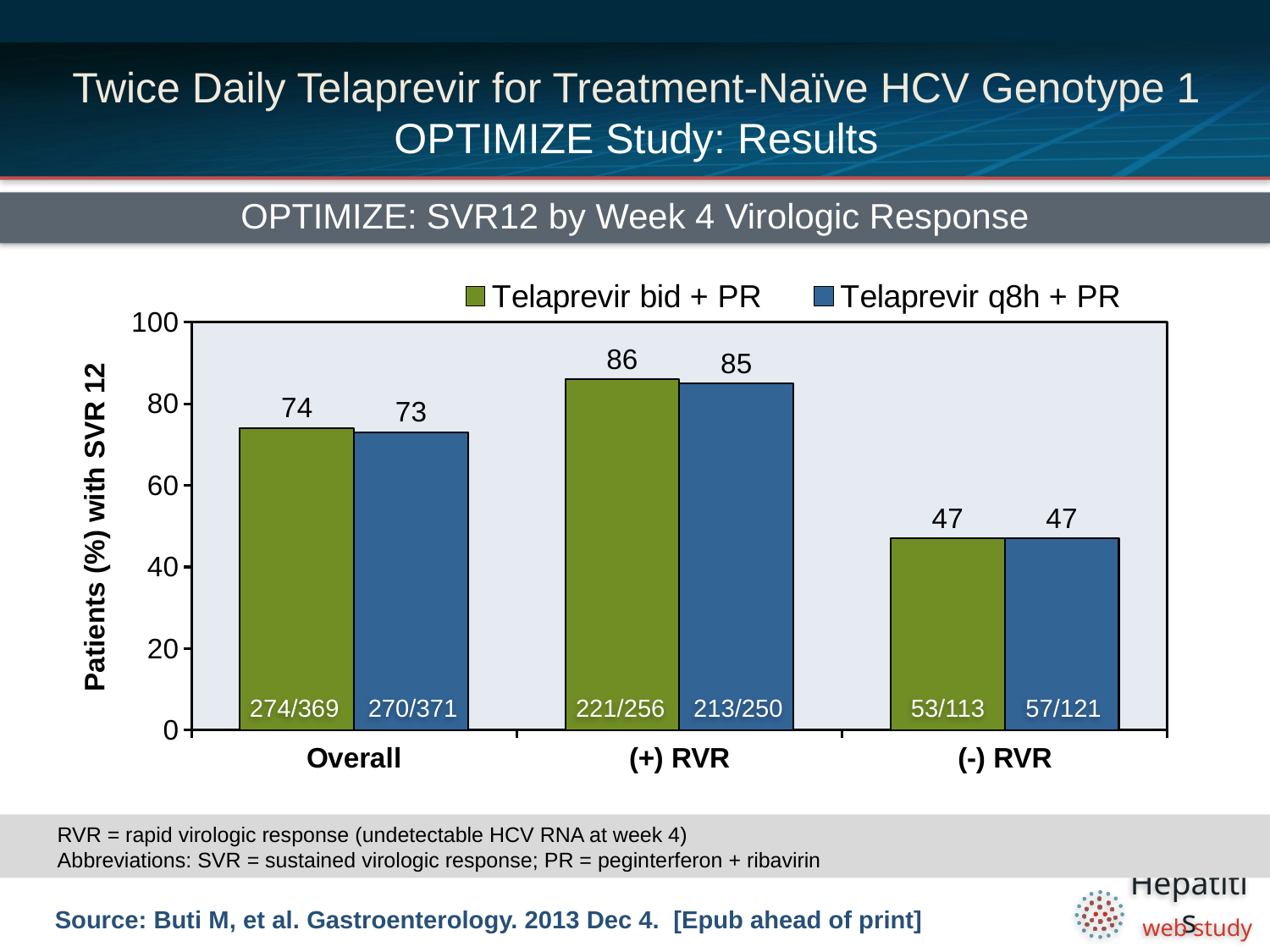
What is the SVR12 rate for Telaprevir bid + PR in the (-) RVR group? 47 What kind of chart is shown on the slide? Bar chart What is the label of the y axis? Patients (%) with SVR 12 How many categories are shown on the x axis? 3 Which is larger in the Overall group: the SVR12 rate for Telaprevir bid + PR or for Telaprevir q8h + PR? Telaprevir bid + PR What is the difference between the Telaprevir bid + PR SVR12 rates for (+) RVR and (-) RVR? 39 What is the SVR12 rate for Telaprevir bid + PR in the Overall group? 74 How many series does the legend list? 2 Which category has the lowest SVR12 rate for Telaprevir q8h + PR? (-) RVR Which category has the highest SVR12 rate for Telaprevir bid + PR? (+) RVR What fraction of patients is shown inside the Telaprevir q8h + PR bar for the Overall group? 270/371 What is the SVR12 rate for Telaprevir q8h + PR in the (+) RVR group? 85